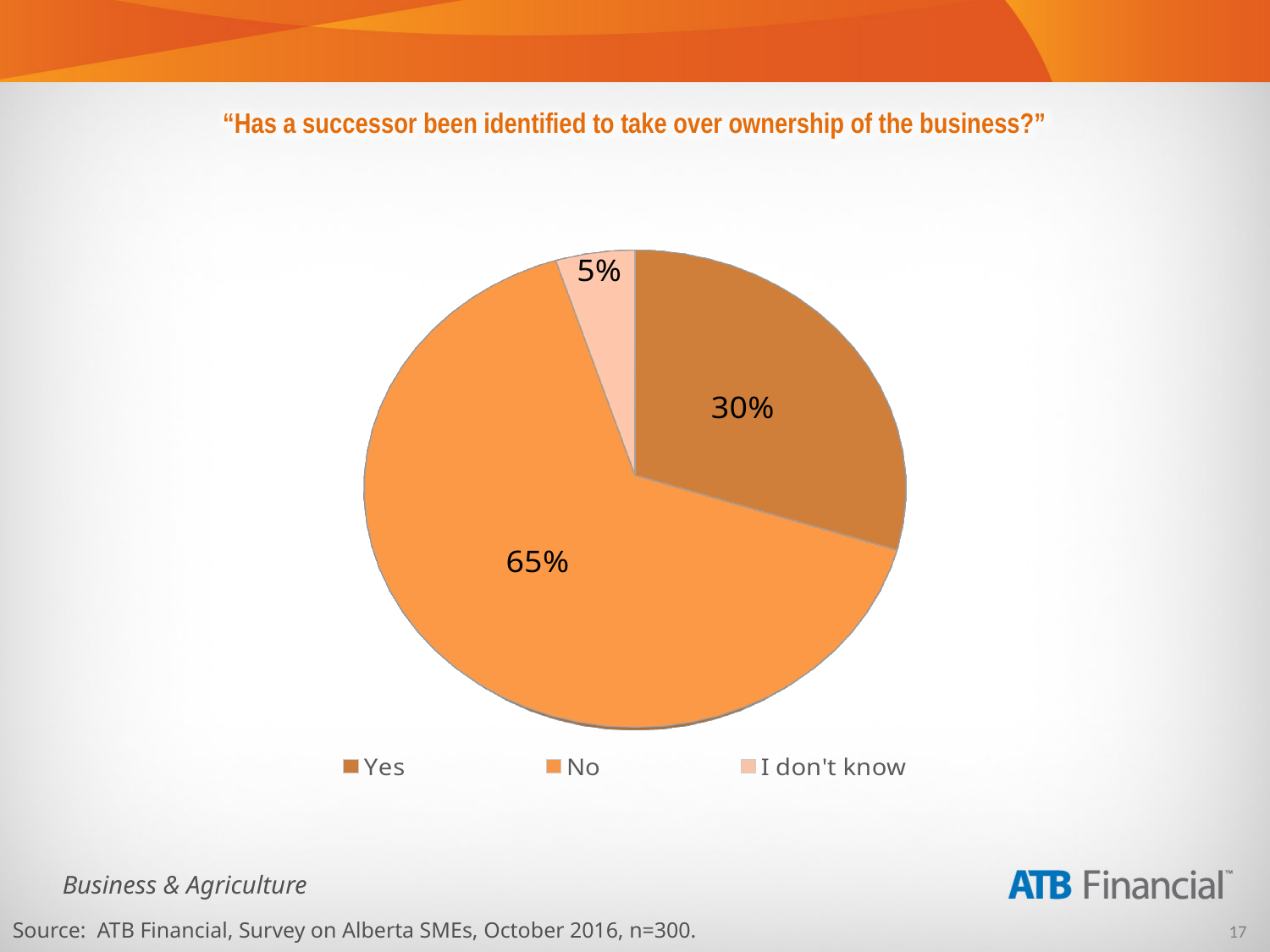
What is the sample size stated in the source note below the chart? n=300 What percentage of respondents answered "I don't know"? 5% What is the difference in percentage points between the "No" and "Yes" slices? 35 What percentage of respondents answered "No"? 65% Which response has the largest share of the pie? No Which response has the smallest share of the pie? I don't know Which is larger, the "Yes" slice or the "I don't know" slice? Yes What question is the chart titled with? "Has a successor been identified to take over ownership of the business?" How many entries does the legend list? 3 What kind of chart is shown on the slide? pie chart How many slices does the pie chart have? 3 What percentage of respondents answered "Yes"? 30%